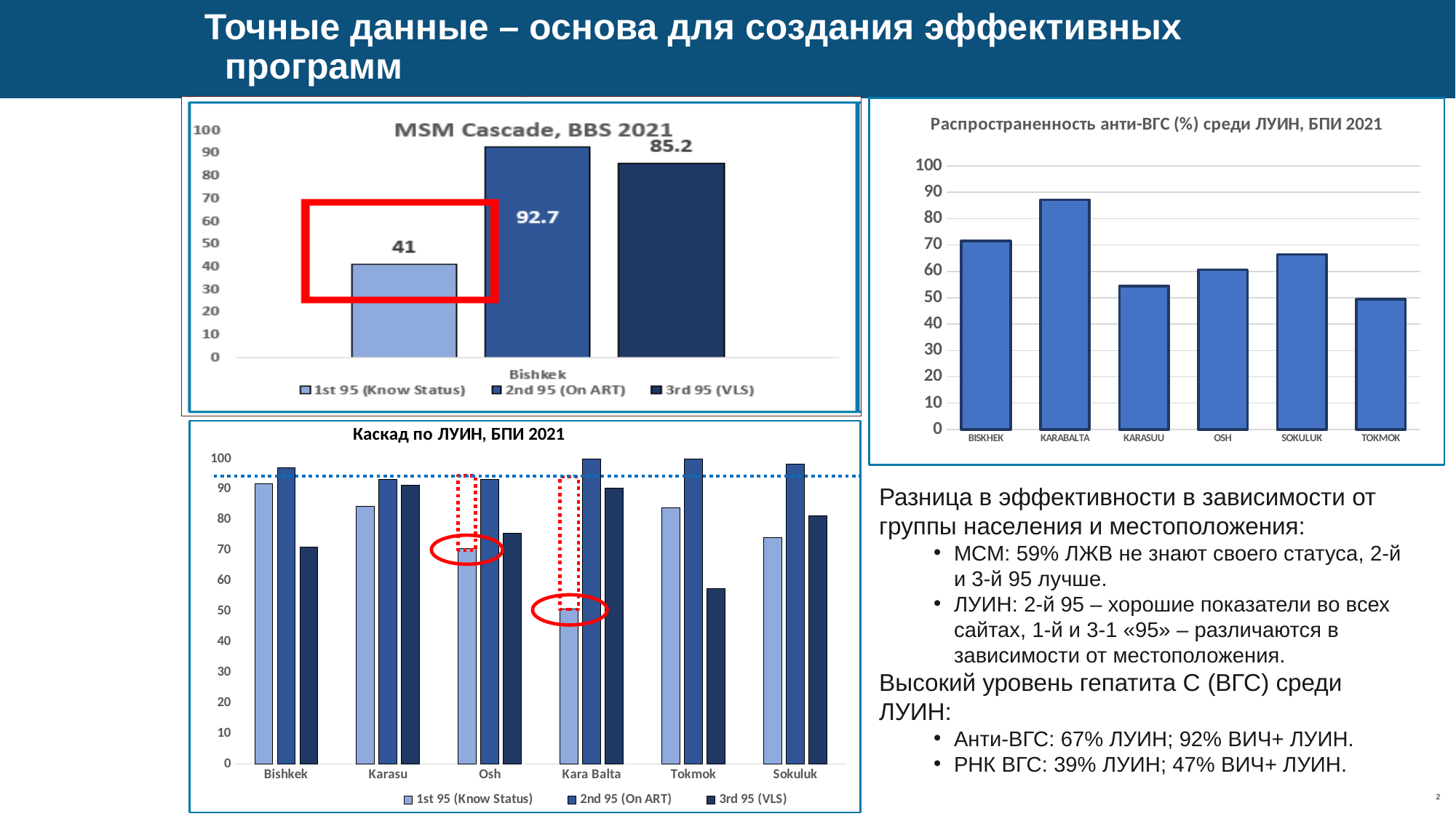
In the MSM Cascade, BBS 2021 chart, what is the difference between the 2nd 95 (On ART) and 3rd 95 (VLS) values? 7.5 In the chart titled 'Распространенность анти-ВГС (%) среди ЛУИН, БПИ 2021', is the value for KARASUU greater or less than 60? less In the MSM Cascade, BBS 2021 chart, what is the value for 1st 95 (Know Status)? 41 In the chart titled 'Распространенность анти-ВГС (%) среди ЛУИН, БПИ 2021', which site has the lowest value? TOKMOK In the MSM Cascade, BBS 2021 chart, what is the value for 3rd 95 (VLS)? 85.2 How many series does the legend of the MSM Cascade, BBS 2021 chart list? 3 In the MSM Cascade, BBS 2021 chart, what is the value for 2nd 95 (On ART)? 92.7 In the chart titled 'Каскад по ЛУИН, БПИ 2021', which is larger: the 1st 95 (Know Status) value for Osh or for Kara Balta? Osh How many sites are shown in the chart titled 'Распространенность анти-ВГС (%) среди ЛУИН, БПИ 2021'? 6 In the chart titled 'Каскад по ЛУИН, БПИ 2021', is the 1st 95 (Know Status) value for Kara Balta greater or less than 60? less In the chart titled 'Распространенность анти-ВГС (%) среди ЛУИН, БПИ 2021', which site has the highest value? KARABALTA In the MSM Cascade, BBS 2021 chart, which series has the lowest value? 1st 95 (Know Status)